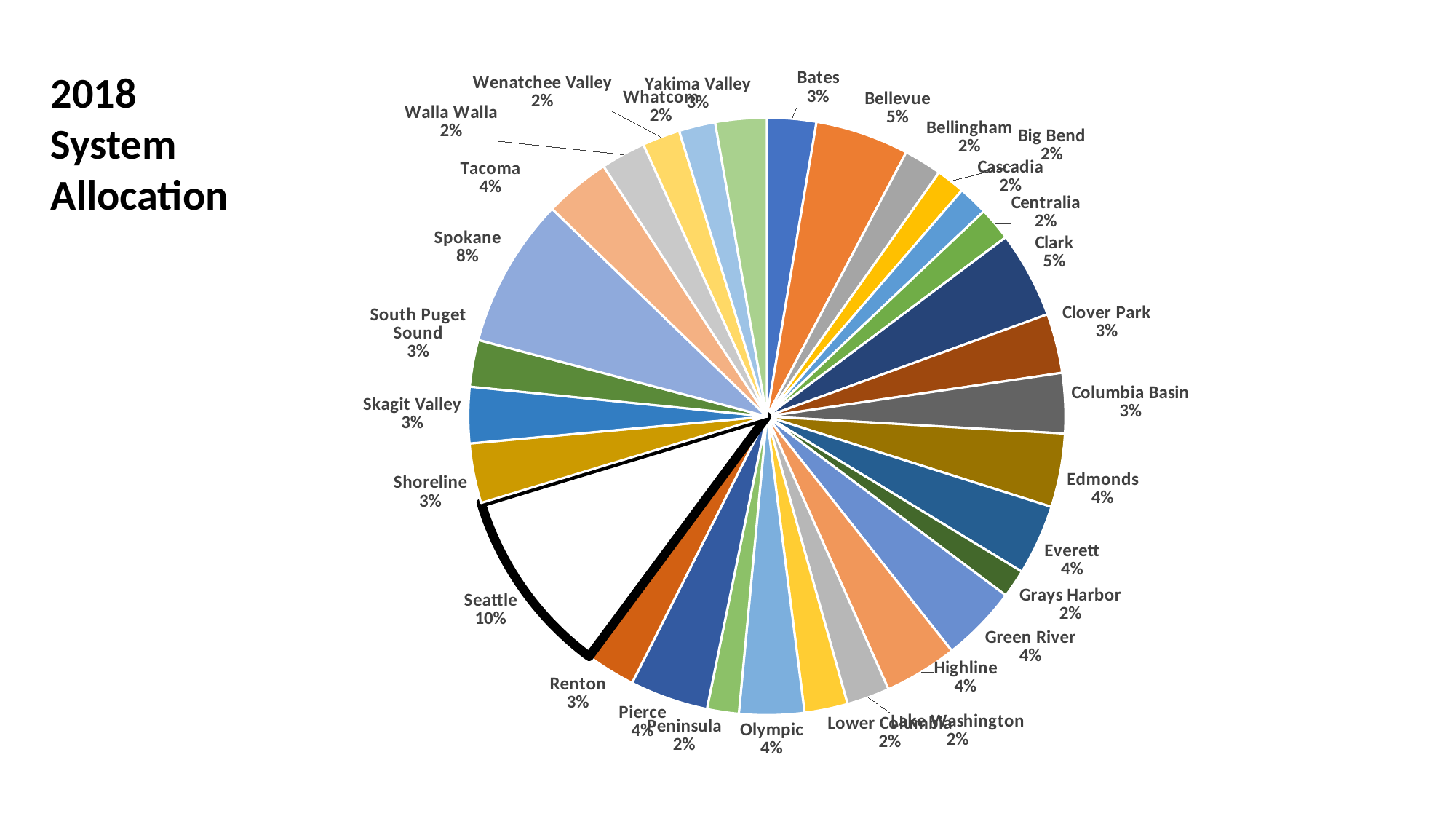
Which slice is outlined with a thick black border? Seattle What type of chart is shown on the slide? Pie chart What is the value shown for Tacoma? 4% What is the value shown for Bellevue? 5% What share of the pie does Seattle have? 10% Which category has the largest slice of the pie? Seattle What is the difference between the Seattle and Spokane percentages? 2% Which is larger, the slice for Spokane or the slice for Clark? Spokane What is the title of the chart? 2018 System Allocation What is the value shown for Spokane? 8% What is the value shown for Walla Walla? 2% Which is larger, the slice for Bellevue or the slice for Bellingham? Bellevue